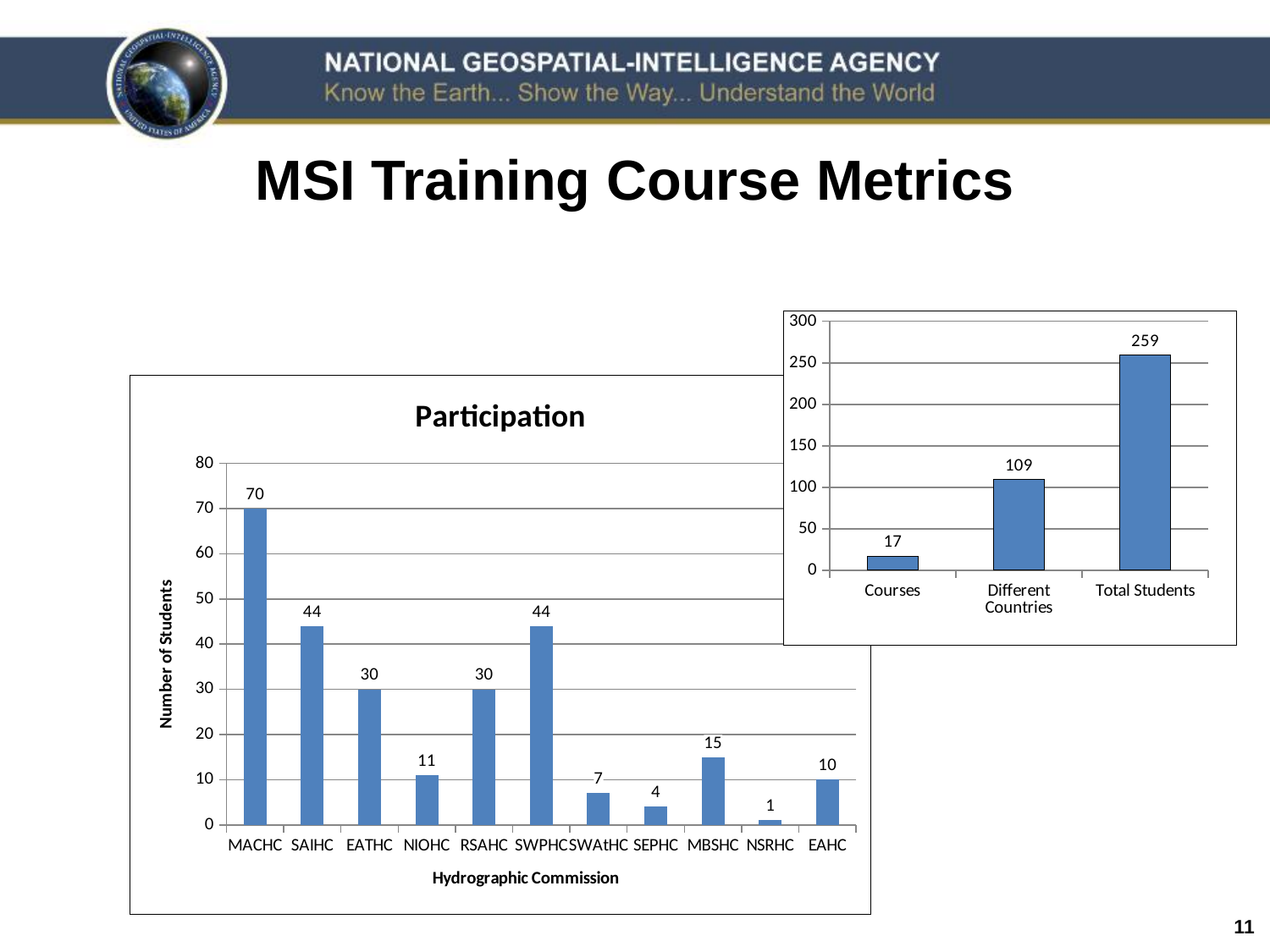
In the Participation chart, which has more students, MBSHC or EAHC? MBSHC In the chart at the top right, what is the value for Total Students? 259 What kind of chart is the Participation chart? bar chart In the Participation chart, what is the difference in number of students between MACHC and SAIHC? 26 In the chart at the top right, what is the difference between Total Students and Different Countries? 150 In the Participation chart, what is the value for NIOHC? 11 In the Participation chart, how many students are shown for MACHC? 70 What is the y-axis label of the Participation chart? Number of Students In the Participation chart, how many hydrographic commissions are shown on the x axis? 11 In the Participation chart, which hydrographic commission has the highest number of students? MACHC In the Participation chart, which hydrographic commission has the lowest number of students? NSRHC In the chart at the top right, what is the value for Different Countries? 109